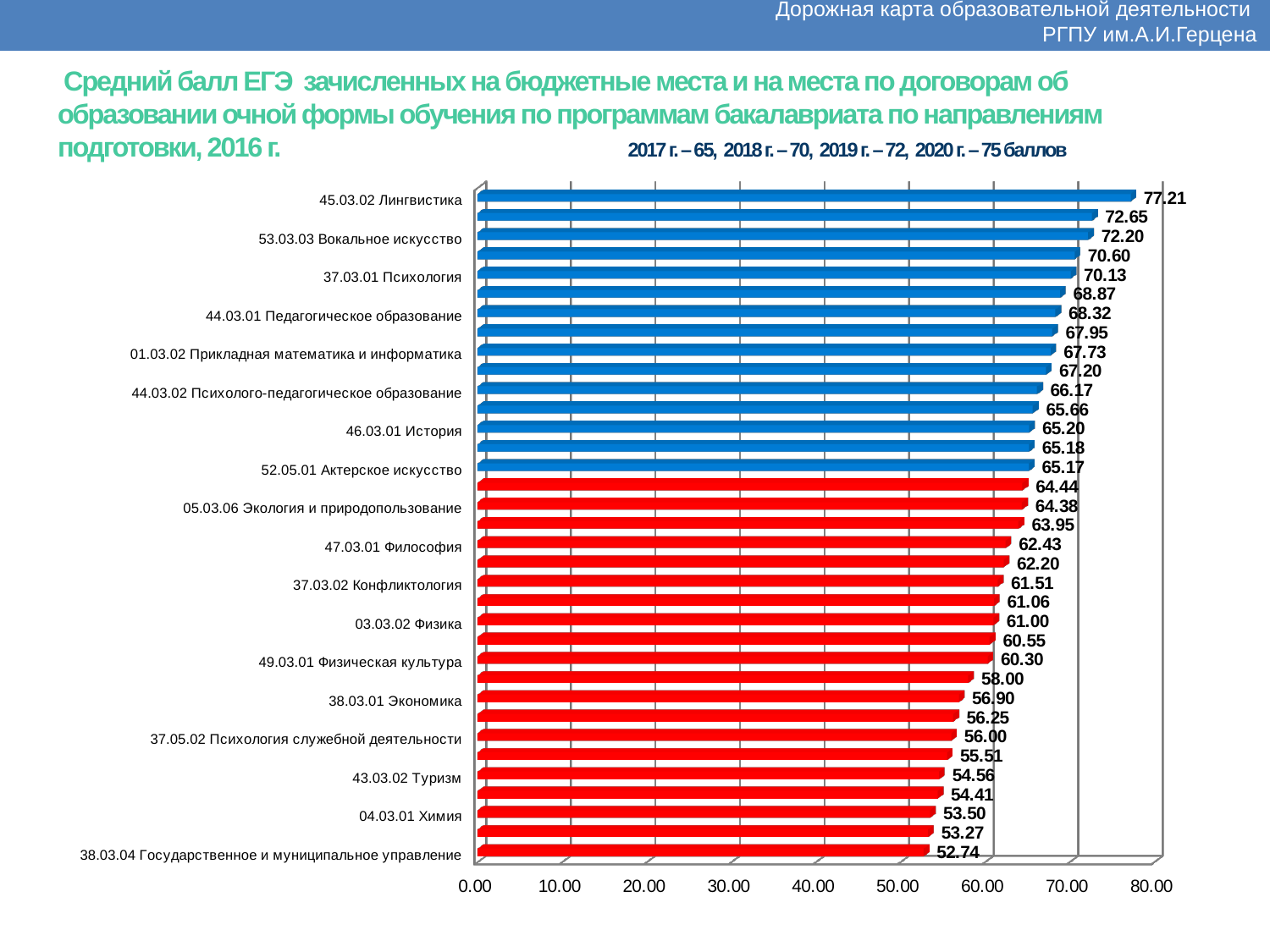
What is the difference between the scores for 45.03.02 Лингвистика and 38.03.04 Государственное и муниципальное управление? 24.47 What type of chart is shown on the slide? bar chart What is the average score for 45.03.02 Лингвистика? 77.21 Which labelled direction has the lowest average score? 38.03.04 Государственное и муниципальное управление What is the maximum value shown on the horizontal axis? 80.00 Is the value for 44.03.01 Педагогическое образование greater or less than 60.00? greater Which has a higher score: 03.03.02 Физика or 38.03.01 Экономика? 03.03.02 Физика What is the average score for 38.03.04 Государственное и муниципальное управление? 52.74 Which labelled direction has the highest average score? 45.03.02 Лингвистика What is the value shown for 43.03.02 Туризм? 54.56 What is the value shown for 37.03.01 Психология? 70.13 What is the difference between the scores for 47.03.01 Философия and 04.03.01 Химия? 8.93